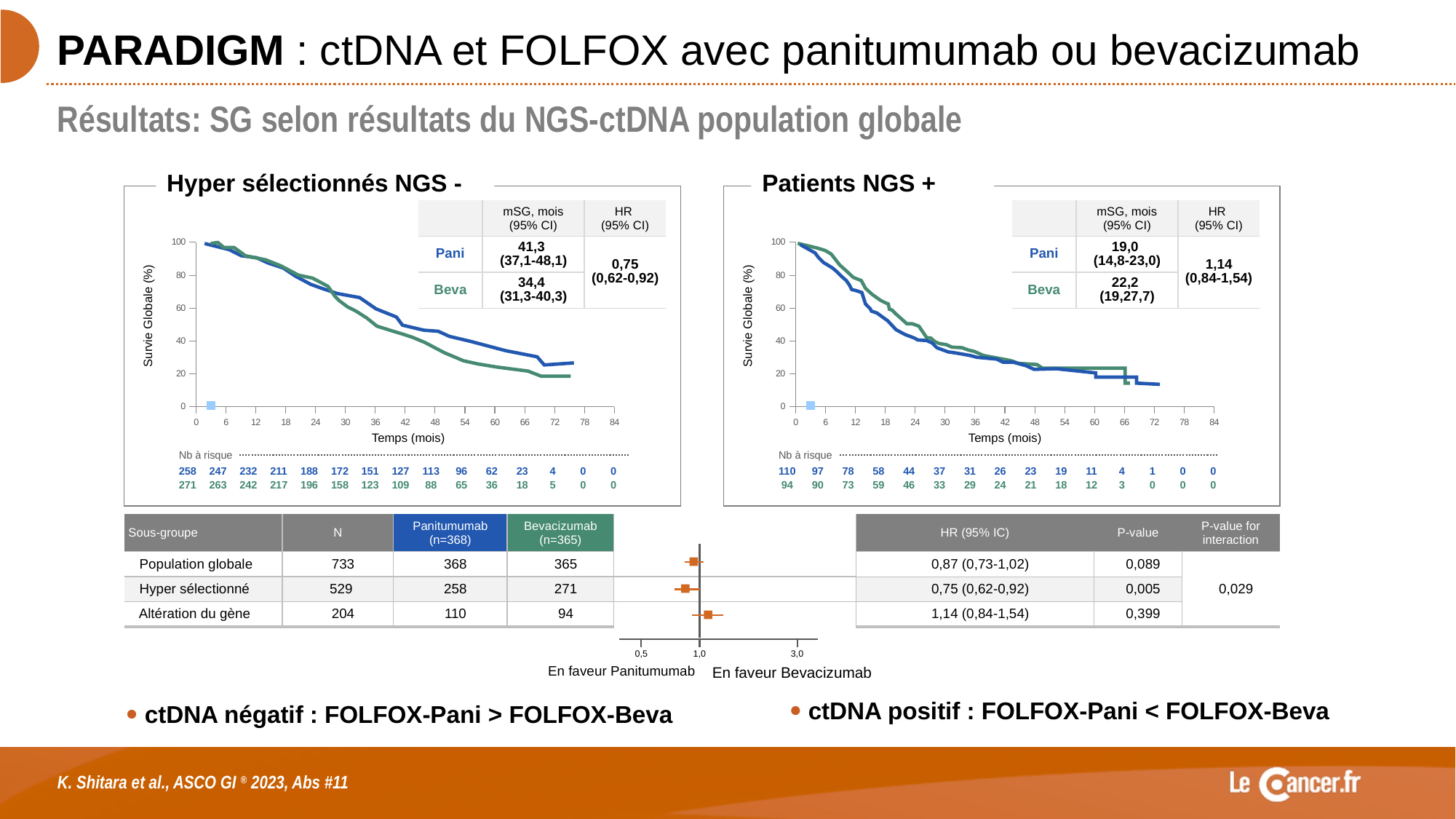
What is the x-axis label of the 'Patients NGS +' chart? Temps (mois) In the forest plot at the bottom, what is the HR (95% IC) for the 'Altération du gène' subgroup? 1,14 (0,84-1,54) In the 'Patients NGS +' chart, how many Beva patients are at risk at 24 months? 46 In the 'Hyper sélectionnés NGS -' chart, what is the HR (95% CI)? 0,75 (0,62-0,92) In the 'Hyper sélectionnés NGS -' chart, how many Pani patients are at risk at 0 months? 258 What kind of chart is the 'Hyper sélectionnés NGS -' chart? Line chart (Kaplan-Meier survival curve) In the 'Patients NGS +' chart, do the survival curves rise or fall along the x axis? Fall In the 'Patients NGS +' chart, which arm has the higher median overall survival, Pani or Beva? Beva In the 'Hyper sélectionnés NGS -' chart, what is the median overall survival (mSG) for Pani? 41,3 In the 'Patients NGS +' chart, what is the median overall survival (mSG) for Beva? 22,2 In the 'Hyper sélectionnés NGS -' chart, is the Pani survival at 72 months greater or less than 20%? greater In the 'Hyper sélectionnés NGS -' chart, what is the difference in median overall survival between Pani and Beva? 6,9